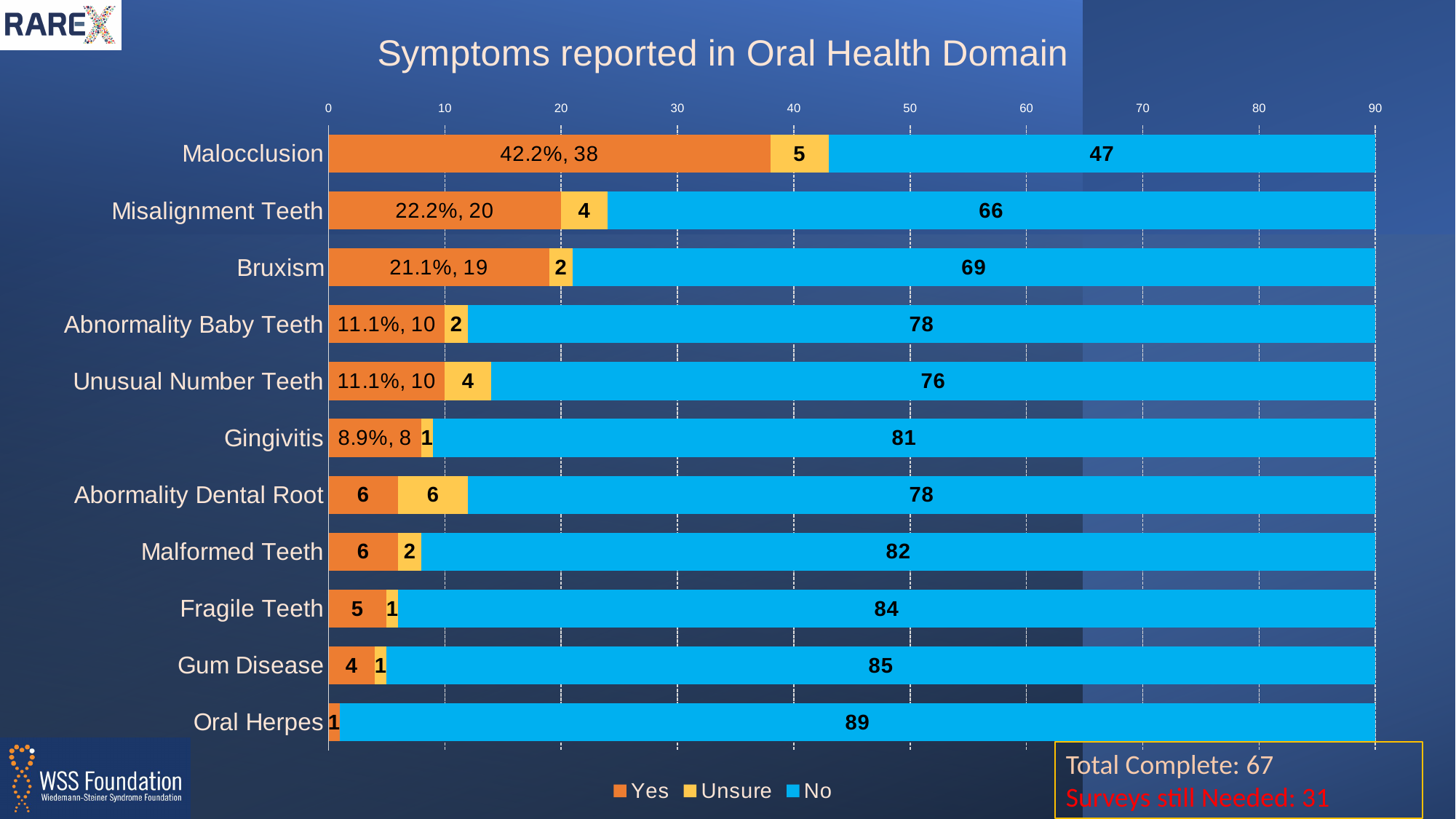
What is the total of the stacked bar for Misalignment Teeth? 90 What is the 'Unsure' value for Abormality Dental Root? 6 What is the title of the chart? Symptoms reported in Oral Health Domain Which is larger, the 'Yes' value for Misalignment Teeth or the 'Yes' value for Bruxism? Misalignment Teeth What kind of chart is shown? Stacked bar chart How many series does the legend list? 3 What is the 'Yes' value for Bruxism? 19 Which symptom has the lowest 'No' value? Malocclusion Which symptom has the highest 'Yes' value? Malocclusion What is the 'No' value for Malocclusion? 47 What is the difference between the 'No' values for Oral Herpes and Malocclusion? 42 How many symptoms are listed on the chart? 11